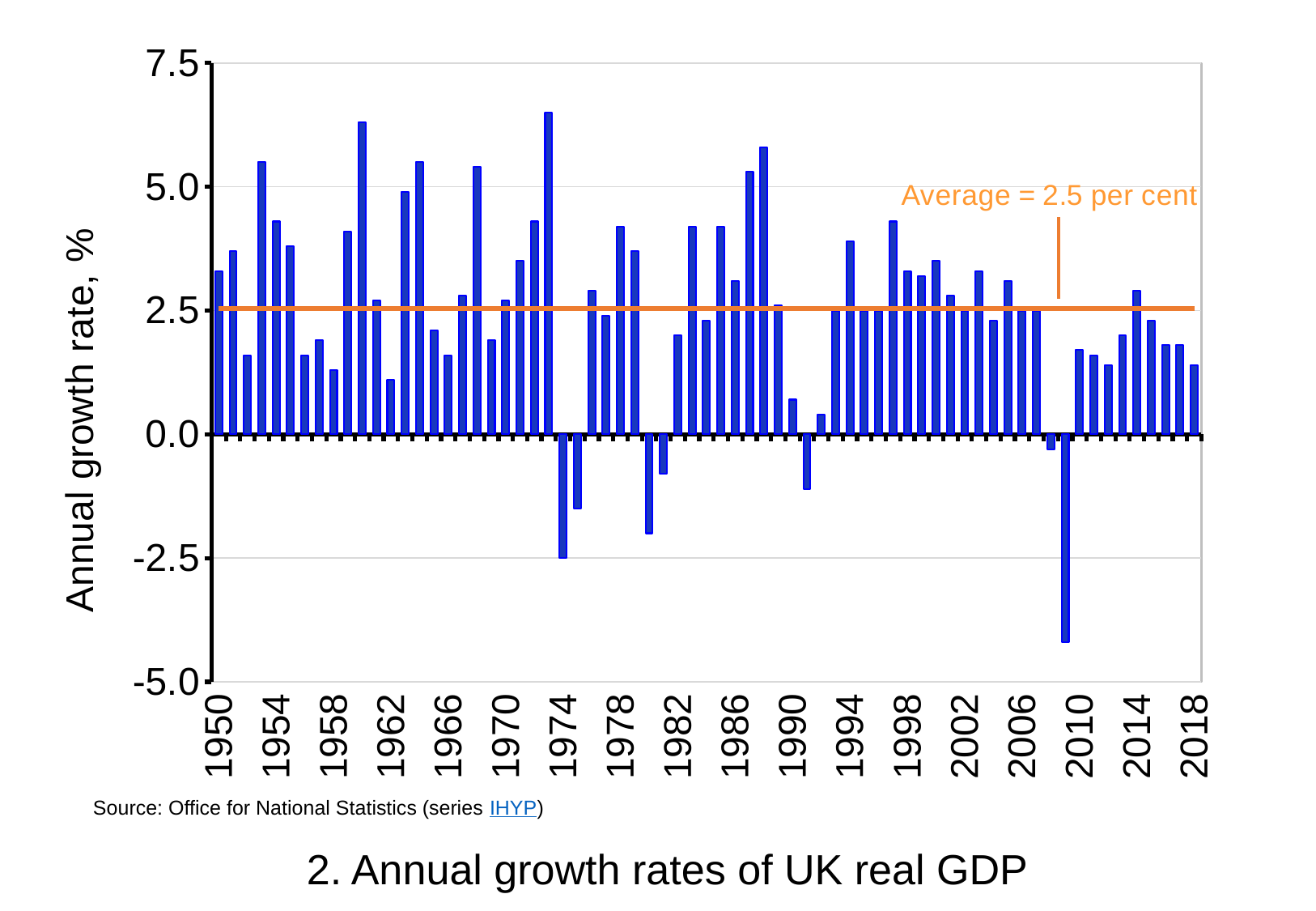
What is the label of the vertical axis? Annual growth rate, % Which year has the higher annual growth rate, 1954 or 1958? 1954 Is the annual growth rate for 1990 greater or less than 2.5? less Is the annual growth rate for 2010 greater or less than 2.5? less Is the annual growth rate for 1978 greater or less than 2.5? greater What kind of chart is shown on the slide? bar chart What is the title of the chart? 2. Annual growth rates of UK real GDP What average growth rate is marked by the horizontal line on the chart? 2.5 per cent